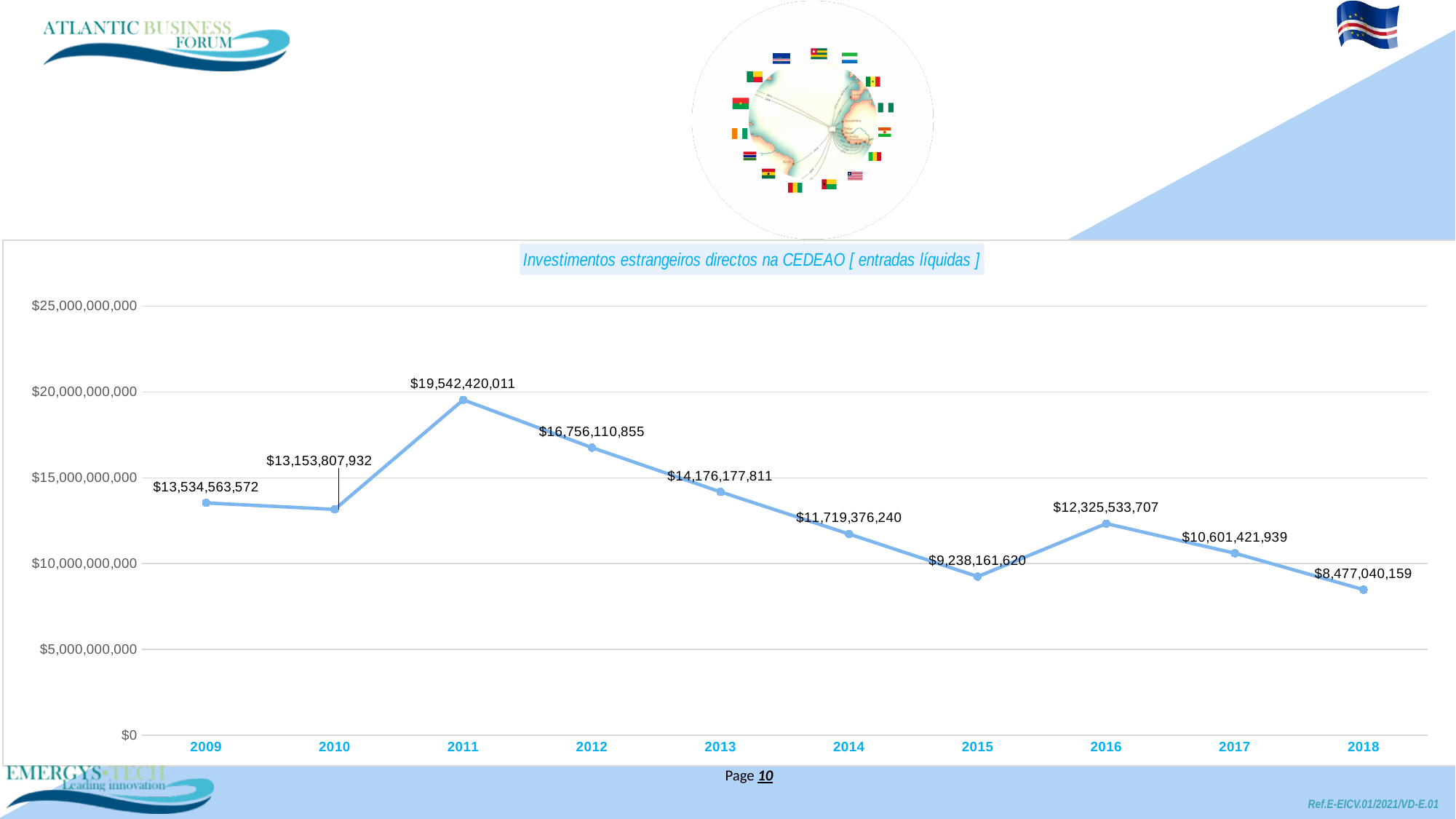
What is the value for 2018? $8,477,040,159 What is the difference between the values for 2009 and 2010? $380,755,640 Which year has the lowest value? 2018 What is the value for 2015? $9,238,161,620 How many years are plotted on the chart? 10 Which is larger, the value for 2016 or the value for 2017? 2016 Is the value for 2015 greater or less than $10,000,000,000? less What is the value for 2011? $19,542,420,011 What is the difference between the values for 2011 and 2018? $11,065,379,852 What kind of chart is shown on the slide? line chart What is the title of the chart? Investimentos estrangeiros directos na CEDEAO [ entradas líquidas ] Which year has the highest value? 2011